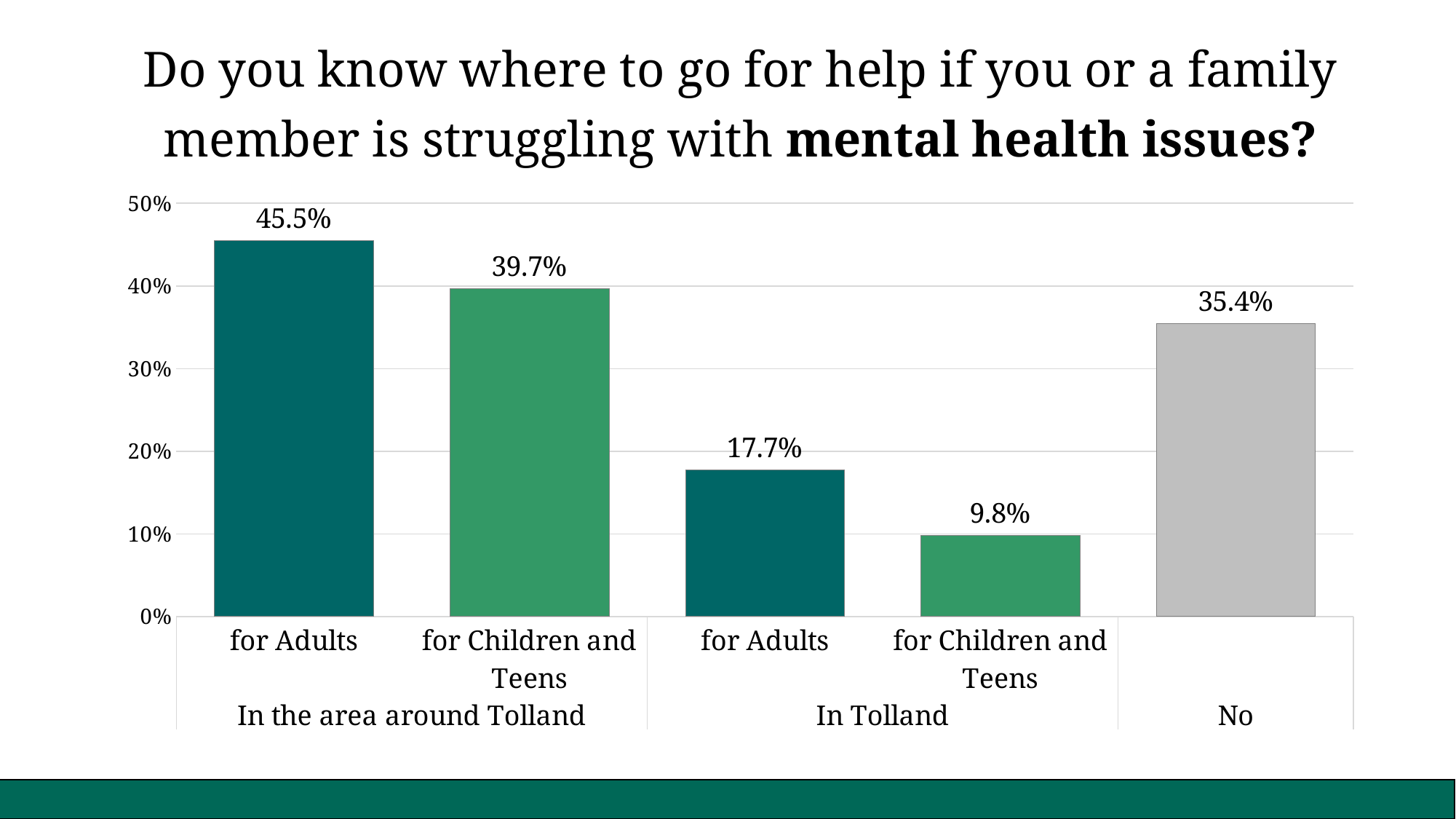
What percentage of respondents answered No? 35.4% How many bars are shown in the chart? 5 Which bar has the highest value? for Adults, In the area around Tolland What percentage of respondents know where to go for help for Adults in the area around Tolland? 45.5% What is the difference between the value for Adults in the area around Tolland and the value for Adults in Tolland? 27.8% Which is larger: the value for Children and Teens in the area around Tolland or the value for No? for Children and Teens in the area around Tolland Is the value for No greater or less than 30%? greater What colour is the bar for No? grey What percentage of respondents know where to go for help for Children and Teens in Tolland? 9.8% What kind of chart is shown on the slide? bar chart What percentage of respondents know where to go for help for Adults in Tolland? 17.7% Which bar has the lowest value? for Children and Teens, In Tolland